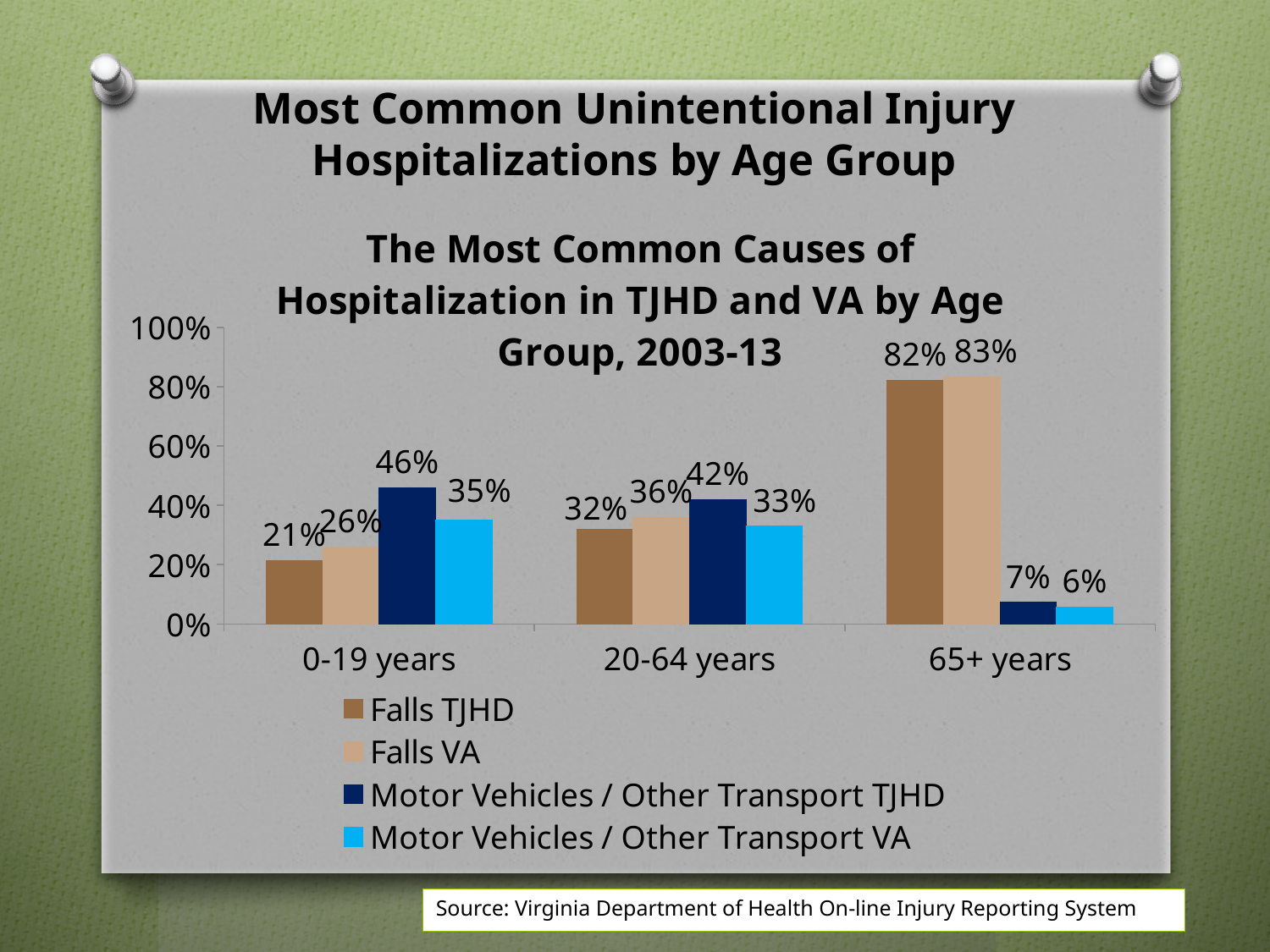
How many series does the legend list? 4 What is the value for Motor Vehicles / Other Transport VA in the 20-64 years age group? 33% What kind of chart is shown on the slide? Bar chart What is the value for Falls TJHD in the 0-19 years age group? 21% Which age group has the highest value for Falls TJHD? 65+ years In the 20-64 years age group, which is larger: Falls VA or Motor Vehicles / Other Transport TJHD? Motor Vehicles / Other Transport TJHD Is the value for Falls TJHD in the 65+ years age group greater or less than 60%? greater Do the values for Falls VA rise or fall across the age groups from 0-19 years to 65+ years? Rise Which age group has the lowest value for Motor Vehicles / Other Transport TJHD? 65+ years What is the difference between Motor Vehicles / Other Transport TJHD and Motor Vehicles / Other Transport VA in the 0-19 years age group? 11% What is the value for Falls VA in the 65+ years age group? 83% How many age groups are shown on the x axis? 3